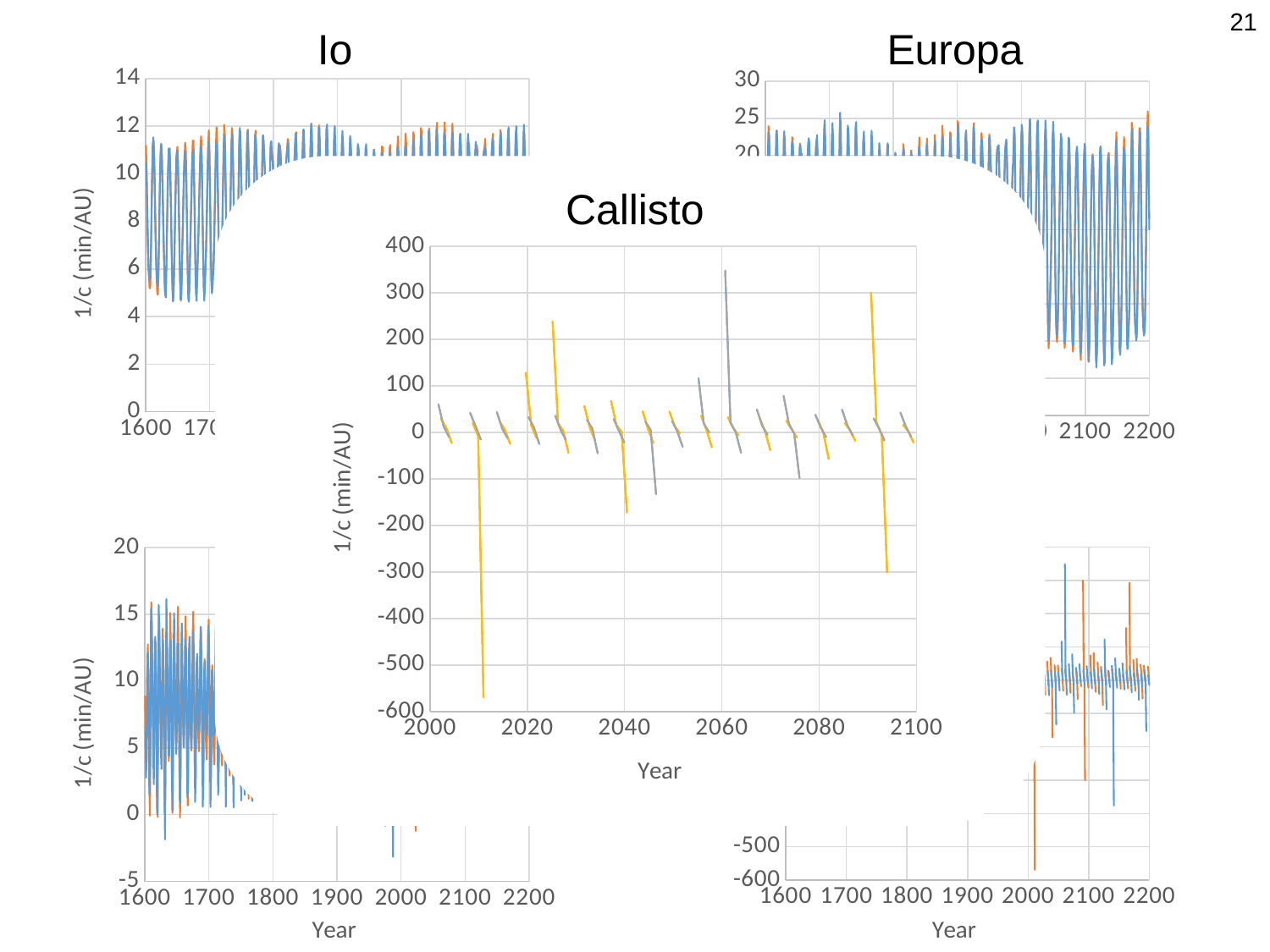
In the Callisto chart, is the highest spike near 2060 greater or less than 300? greater What is the y-axis title of the Callisto chart? 1/c (min/AU) In the Callisto chart, is the lowest spike near 2010 greater or less than -500? less How many charts are shown on the slide? 5 What type of chart is the Io chart? Line chart What is the x-axis title of the Callisto chart? Year In the Callisto chart, is the spike near 2025 greater or less than 200? greater What type of chart is the Callisto chart? Line chart